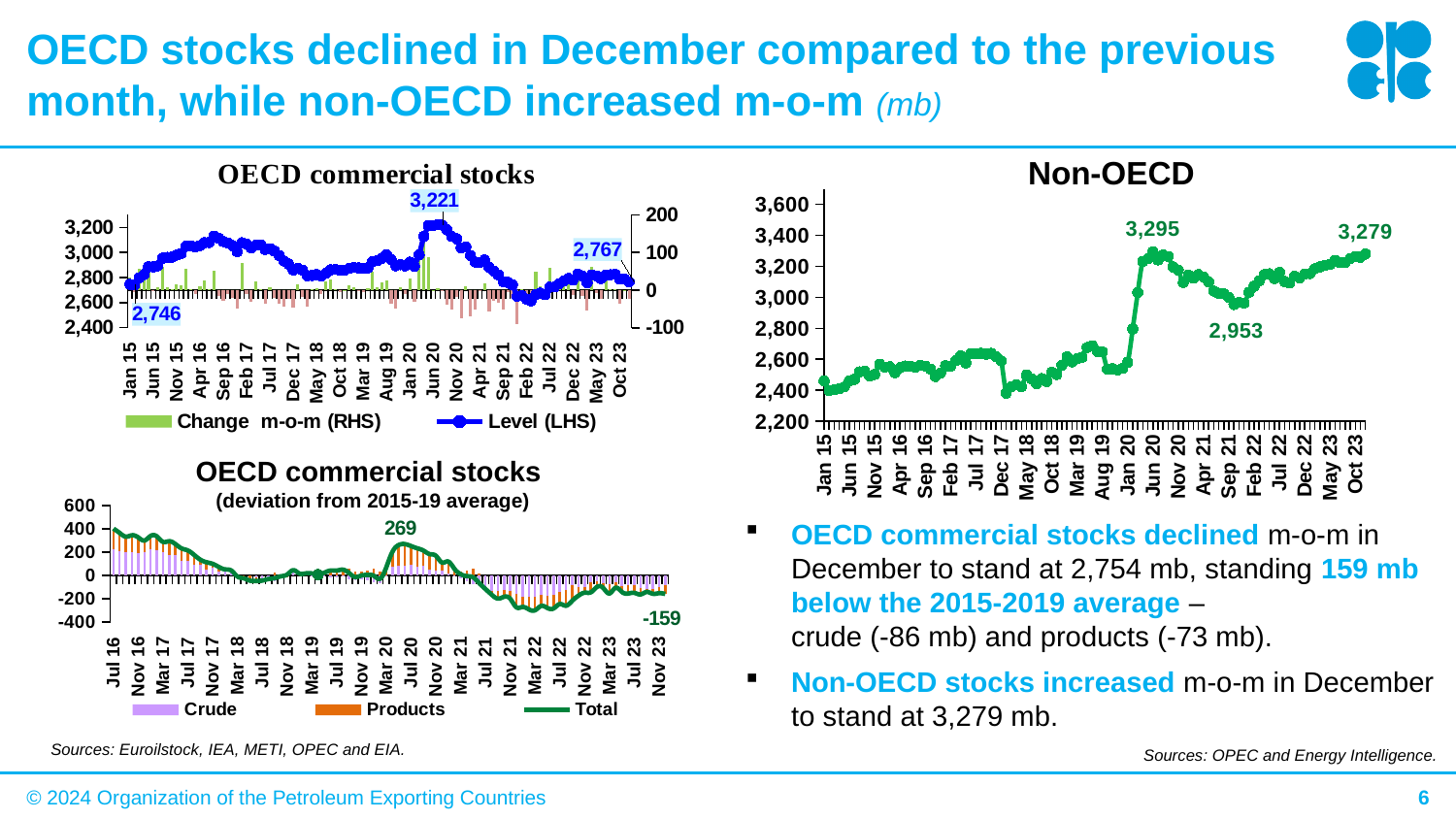
How many series does the legend of the OECD commercial stocks deviation chart (bottom left) list? 3 In the Non-OECD chart, what is the difference between the labelled values 3,295 and 2,953? 342 In the OECD commercial stocks chart (top left), what is the peak level value labelled on the chart? 3,221 In the OECD commercial stocks chart (top left), what is the difference between the labelled peak level of 3,221 and the labelled starting level of 2,746? 475 In the Non-OECD chart, what is the peak value labelled on the line? 3,295 In the OECD commercial stocks chart (top left), what is the latest level value labelled at the end of the series? 2,767 In the OECD commercial stocks deviation chart (bottom left), what is the latest Total value labelled at the end of the series? -159 In the Non-OECD chart, what is the value labelled at the end of the series? 3,279 How many series does the legend of the OECD commercial stocks chart (top left) list? 2 In the OECD commercial stocks chart (top left), what level value is labelled at the start of the series in Jan 15? 2,746 In the Non-OECD chart, is the value in Jan 15 greater or less than 2,600? less In the Non-OECD chart, what is the labelled low value around Sep 21? 2,953